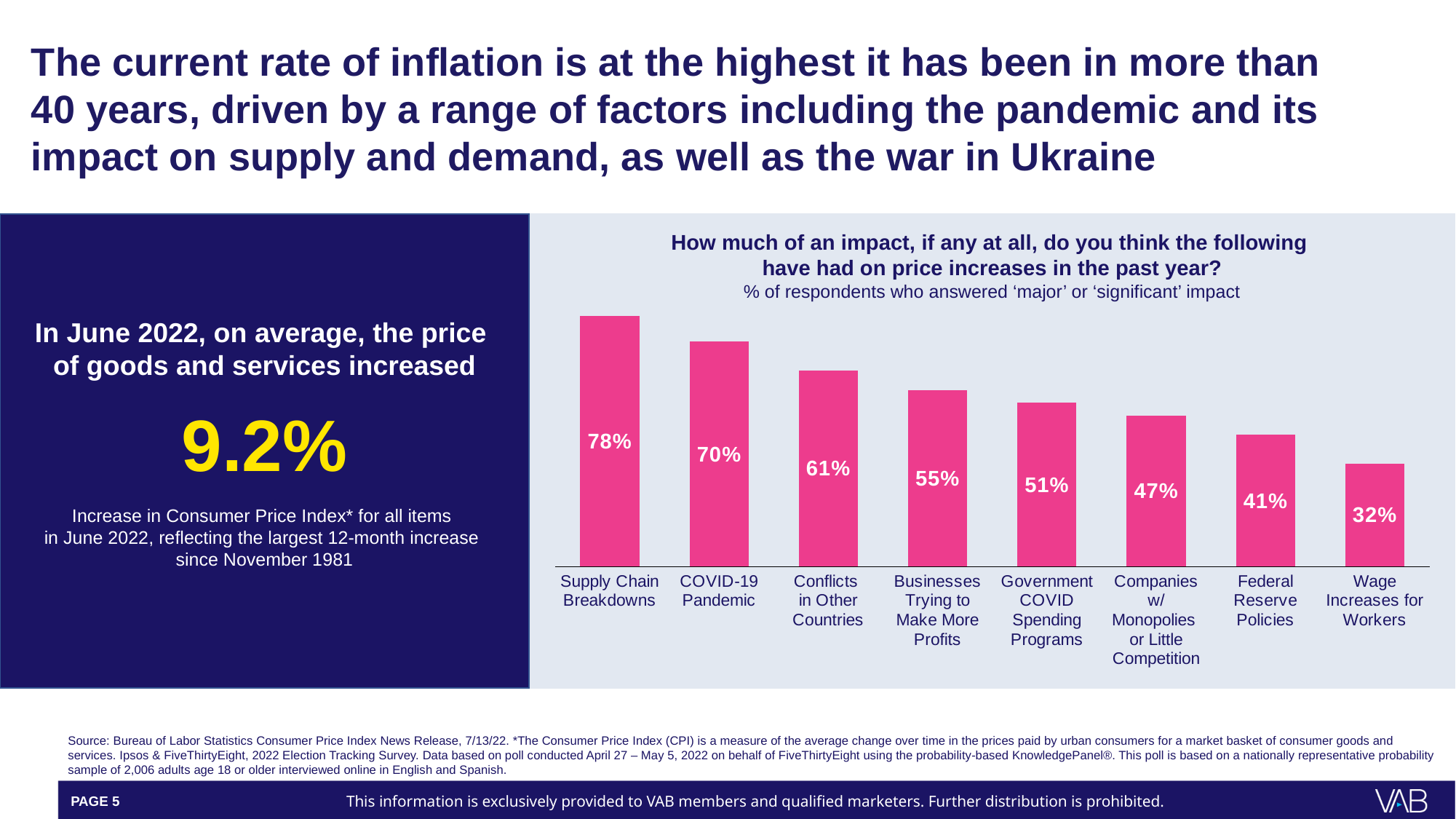
What is the value shown for Federal Reserve Policies? 41% What percentage of respondents said Supply Chain Breakdowns had a major or significant impact on price increases? 78% Do the values rise or fall moving from left to right across the chart? Fall Which category has the lowest value in the chart? Wage Increases for Workers Which is larger: the value for Businesses Trying to Make More Profits or the value for Companies w/ Monopolies or Little Competition? Businesses Trying to Make More Profits How many categories are shown in the chart? 8 Which category has the highest value in the chart? Supply Chain Breakdowns What is the value shown for Government COVID Spending Programs? 51% What colour are the bars in the chart? Pink What kind of chart is shown on the slide? Bar chart What is the difference between the values for Supply Chain Breakdowns and Wage Increases for Workers? 46% What is the difference between the values for COVID-19 Pandemic and Conflicts in Other Countries? 9%